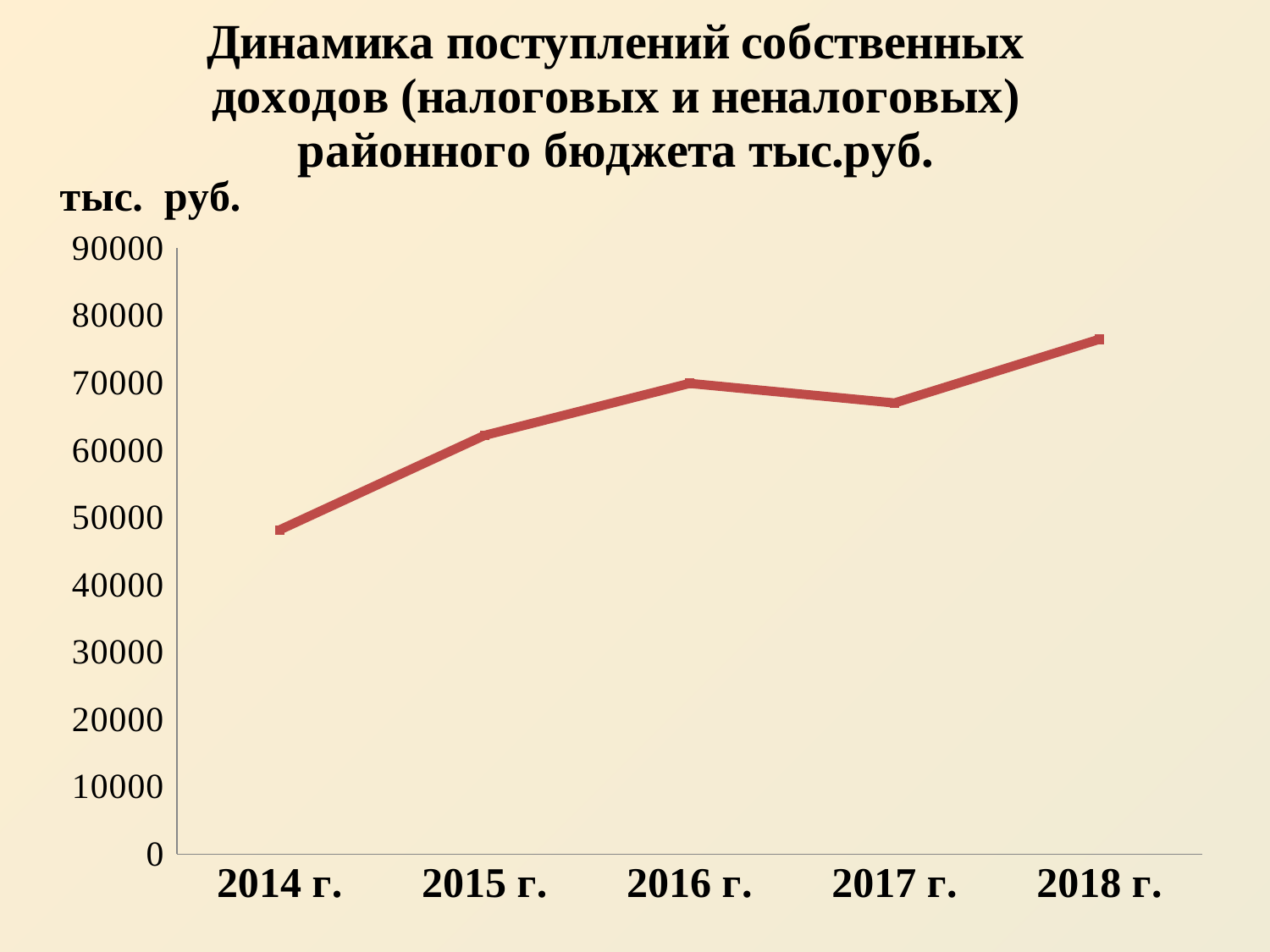
Which year has the highest value on the chart? 2018 г. Which year has the lowest value on the chart? 2014 г. What kind of chart is shown on the slide? line chart Is the value for 2014 г. greater or less than 50000? less Is the value for 2017 г. greater or less than 70000? less What unit is shown as the label of the vertical axis? тыс. руб. Is the value for 2018 г. greater or less than 80000? less Which is larger, the value for 2014 г. or the value for 2015 г.? 2015 г. Do the values generally rise or fall from 2014 г. to 2018 г.? rise How many years are plotted on the x axis of the chart? 5 Which is larger, the value for 2016 г. or the value for 2017 г.? 2016 г.